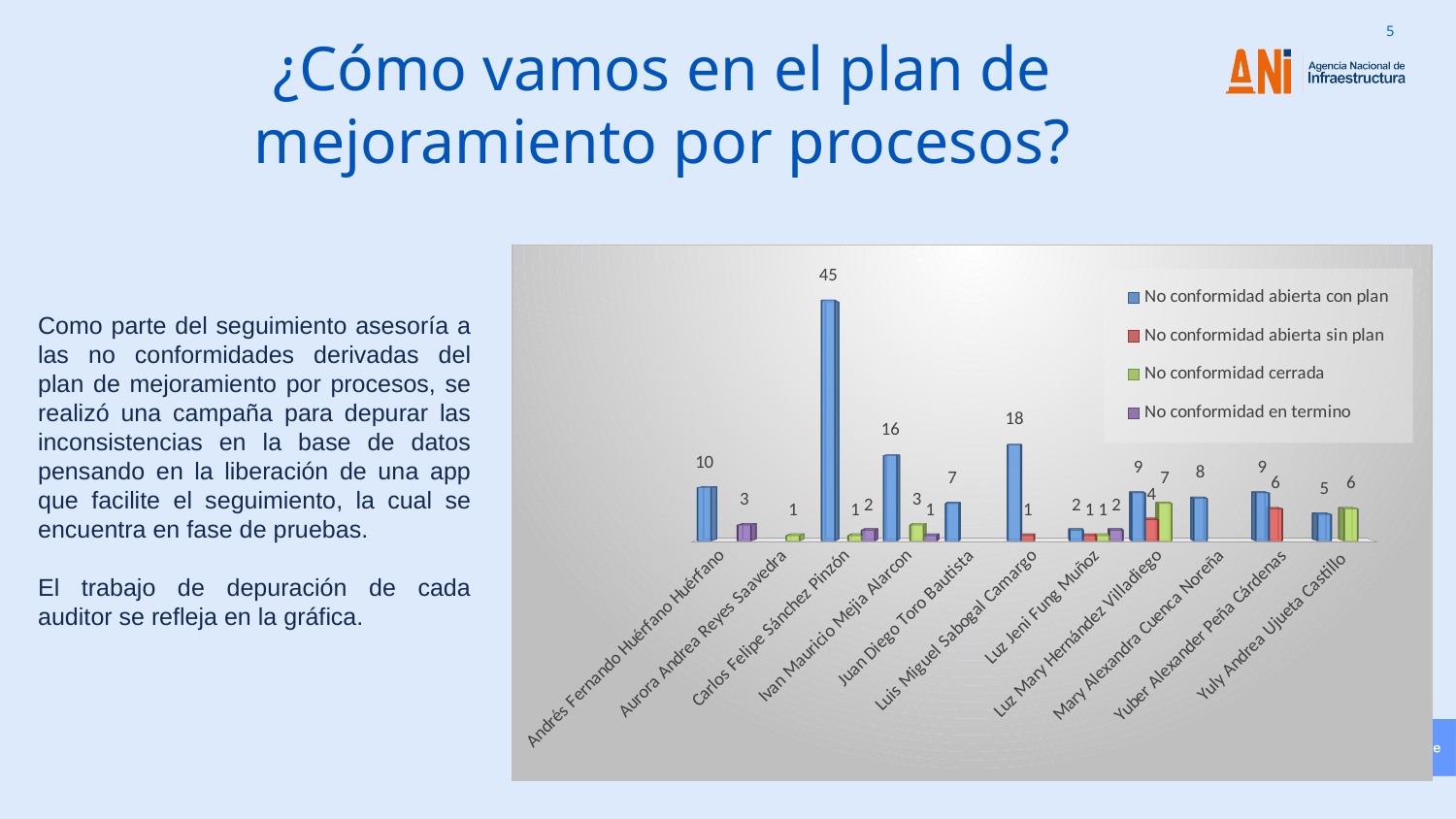
What is the value of 'No conformidad en termino' for Andrés Fernando Huérfano Huérfano? 3 What is the difference between the 'No conformidad abierta con plan' values for Carlos Felipe Sánchez Pinzón and Ivan Mauricio Mejia Alarcon? 29 Which legend entry is shown in blue? No conformidad abierta con plan How many auditors (categories) are shown on the x axis of the chart? 11 What is the value of 'No conformidad abierta con plan' for Carlos Felipe Sánchez Pinzón? 45 What type of chart is shown on the slide? Bar chart Which is larger for Yuly Andrea Ujueta Castillo: 'No conformidad abierta con plan' or 'No conformidad cerrada'? No conformidad cerrada What is the value of 'No conformidad abierta con plan' for Luis Miguel Sabogal Camargo? 18 What is the value of 'No conformidad abierta sin plan' for Yuber Alexander Peña Cárdenas? 6 What is the value of 'No conformidad cerrada' for Luz Mary Hernández Villadiego? 7 Which auditor has the highest value for 'No conformidad abierta con plan'? Carlos Felipe Sánchez Pinzón How many series does the chart legend list? 4